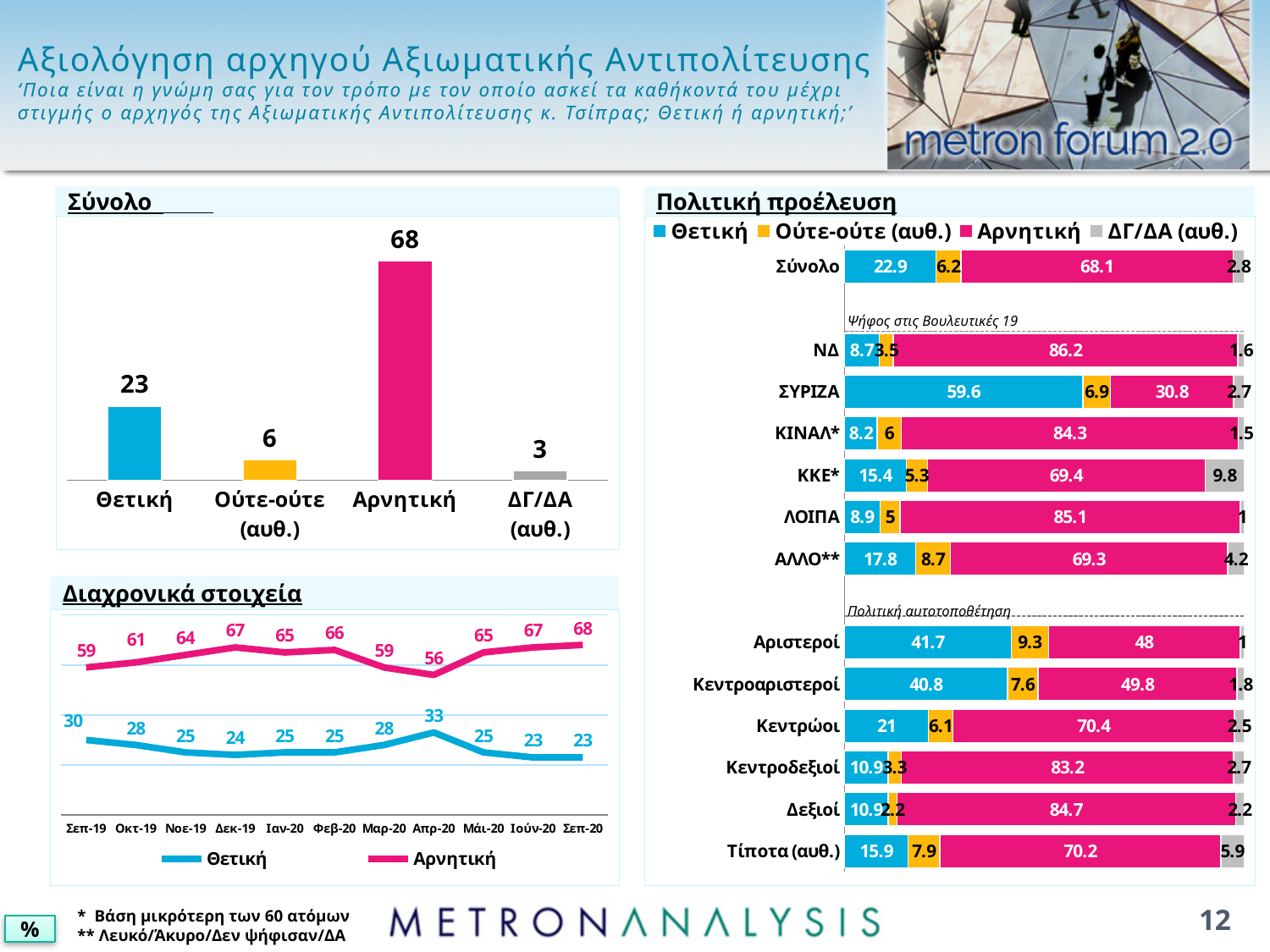
In the 'Πολιτική προέλευση' chart, which is larger: the Θετική value for Αριστεροί or for Κεντροαριστεροί? Αριστεροί In the 'Σύνολο' chart, which category has the lowest value? ΔΓ/ΔΑ (αυθ.) In the 'Διαχρονικά στοιχεία' chart, how many time points are shown on the x axis? 11 In the 'Σύνολο' chart, what is the difference between the values for Αρνητική and Θετική? 45 In the 'Διαχρονικά στοιχεία' chart, does the Θετική series rise or fall from Απρ-20 to Σεπ-20? Fall In the 'Σύνολο' chart, what is the value for Αρνητική? 68 In the 'Πολιτική προέλευση' chart, which group has the highest Αρνητική value? ΝΔ What kind of chart is the 'Σύνολο' chart? Bar chart In the 'Πολιτική προέλευση' chart, what is the Θετική value for ΣΥΡΙΖΑ? 59.6 In the 'Διαχρονικά στοιχεία' chart, what is the value of Θετική for Απρ-20? 33 In the 'Διαχρονικά στοιχεία' chart, how many series does the legend list? 2 In the 'Πολιτική προέλευση' chart, how many series does the legend list? 4